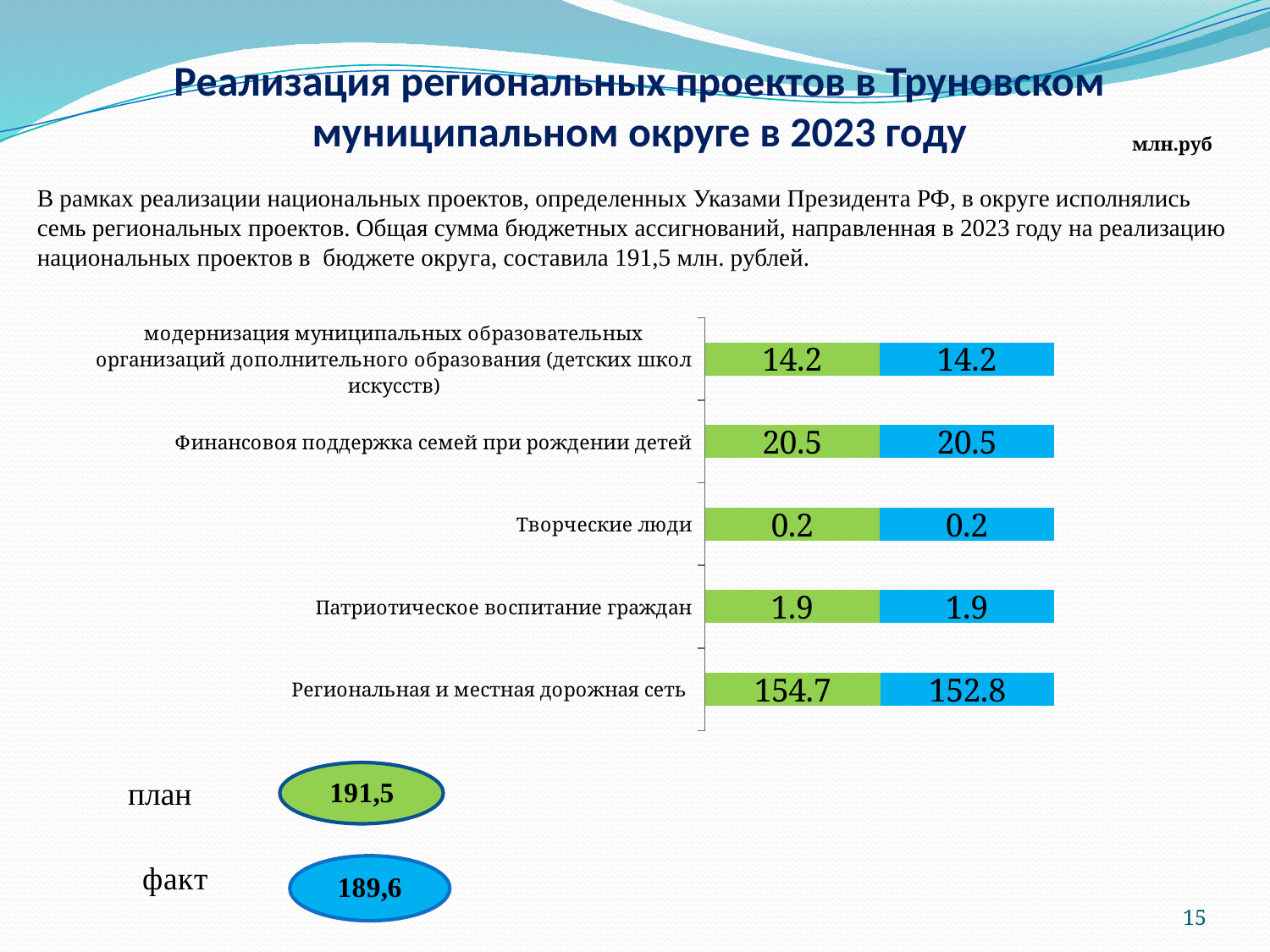
What is the difference between the green (план) and blue (факт) values for Региональная и местная дорожная сеть? 1.9 Which category has the highest green (план) value? Региональная и местная дорожная сеть How many categories are shown in the chart? 5 What kind of chart is shown on the slide? stacked bar chart Which category has the lowest blue (факт) value? Творческие люди What is the green (план) value for Патриотическое воспитание граждан? 1.9 What is the blue (факт) value for Региональная и местная дорожная сеть? 152.8 Which is larger for Региональная и местная дорожная сеть: the green (план) value or the blue (факт) value? green (план) What is the green (план) value for Финансовоя поддержка семей при рождении детей? 20.5 How many series does the chart show? 2 What is the blue (факт) value for Творческие люди? 0.2 What is the green (план) value for Региональная и местная дорожная сеть? 154.7